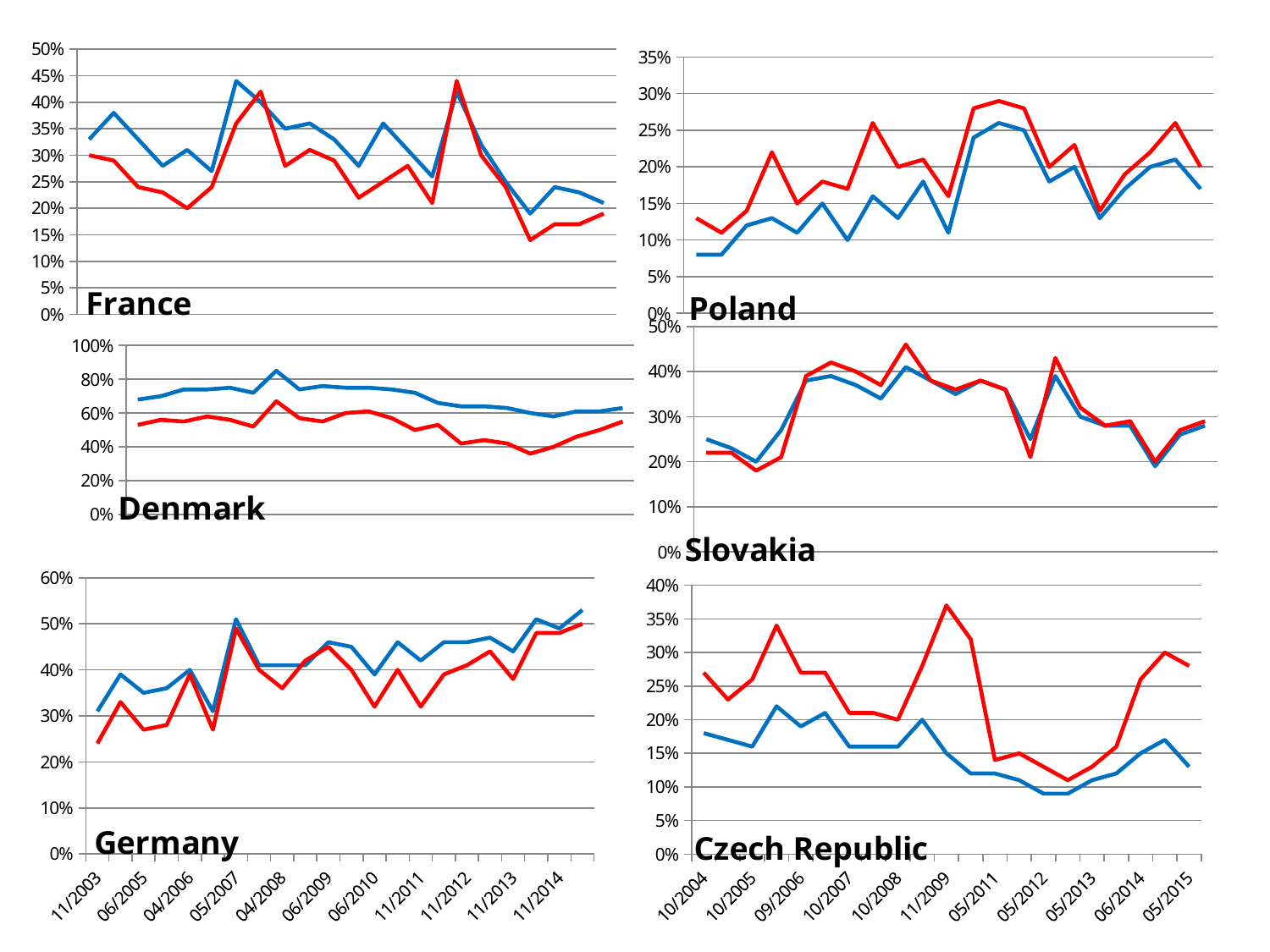
In the Germany chart, is the red line's value at 11/2003 greater or less than 30%? less In the Czech Republic chart, does the blue line overall rise or fall from 10/2004 to 05/2015? fall How many charts are shown on the slide? 6 In the Czech Republic chart, which line is higher across the whole period, the red or the blue? red What kind of chart is the France chart? line chart In the Poland chart, does the red line ever rise above 25%? Yes How many lines (data series) are plotted on the Germany chart? 2 Which country's chart has a y-axis that goes up to 100%? Denmark In the Czech Republic chart, is the red line's value at 10/2004 greater or less than 25%? greater In the Czech Republic chart, at which x-axis label does the red line reach its highest value? 11/2009 In the Denmark chart, which line is higher across the whole period, the red or the blue? blue